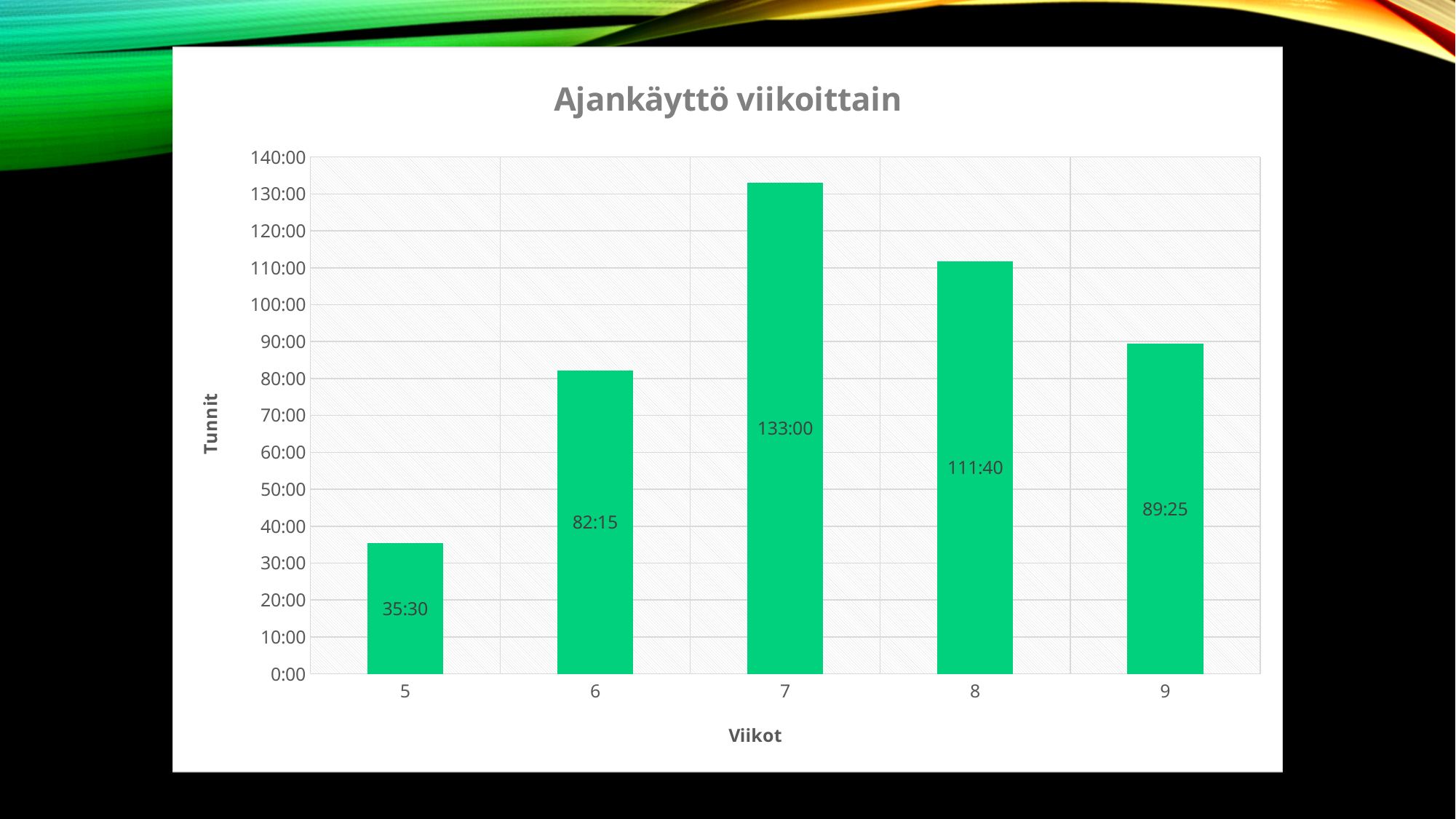
Is the value for week 6 greater or less than 90:00? less What is the difference between the values for week 6 and week 5? 46:45 What is the value for week 5? 35:30 How many weeks are shown on the x axis? 5 Which week has the lowest value? 5 Which week has the highest value? 7 What is the difference between the values for week 7 and week 8? 21:20 Do the values rise or fall from week 7 to week 9? fall What kind of chart is this? bar chart What is the value for week 9? 89:25 Which is larger, the value for week 8 or the value for week 9? week 8 What is the value for week 7? 133:00